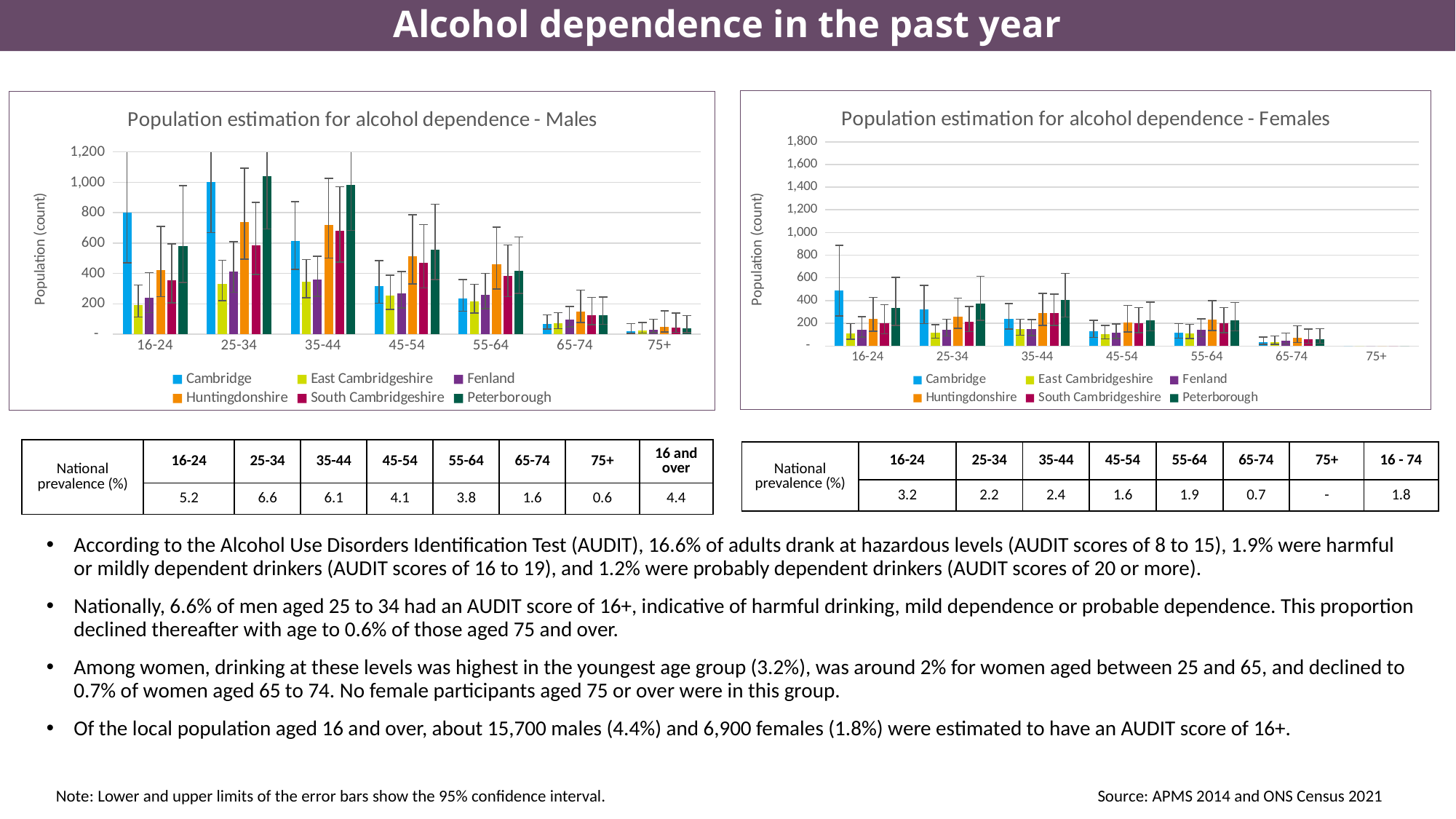
In the 'Population estimation for alcohol dependence - Males' chart, which age group has the highest Cambridge bar? 25-34 How many age group categories are shown on the x axis of the 'Population estimation for alcohol dependence - Males' chart? 7 In the 'Population estimation for alcohol dependence - Males' chart, do the Cambridge bars rise or fall from 35-44 to 75+? fall In the 'Population estimation for alcohol dependence - Males' chart, is the Cambridge value for 16-24 greater or less than 600? greater In the 'Population estimation for alcohol dependence - Males' chart, which is larger for the 25-34 age group: Cambridge or East Cambridgeshire? Cambridge What kind of chart is the 'Population estimation for alcohol dependence - Males' chart? Bar chart In the 'Population estimation for alcohol dependence - Females' chart, is the Cambridge value for 16-24 greater or less than 400? greater In the 'Population estimation for alcohol dependence - Females' chart, is the Peterborough value for 35-44 greater or less than 600? less In the 'Population estimation for alcohol dependence - Females' chart, which age group has the highest Cambridge bar? 16-24 How many series does the legend of the 'Population estimation for alcohol dependence - Females' chart list? 6